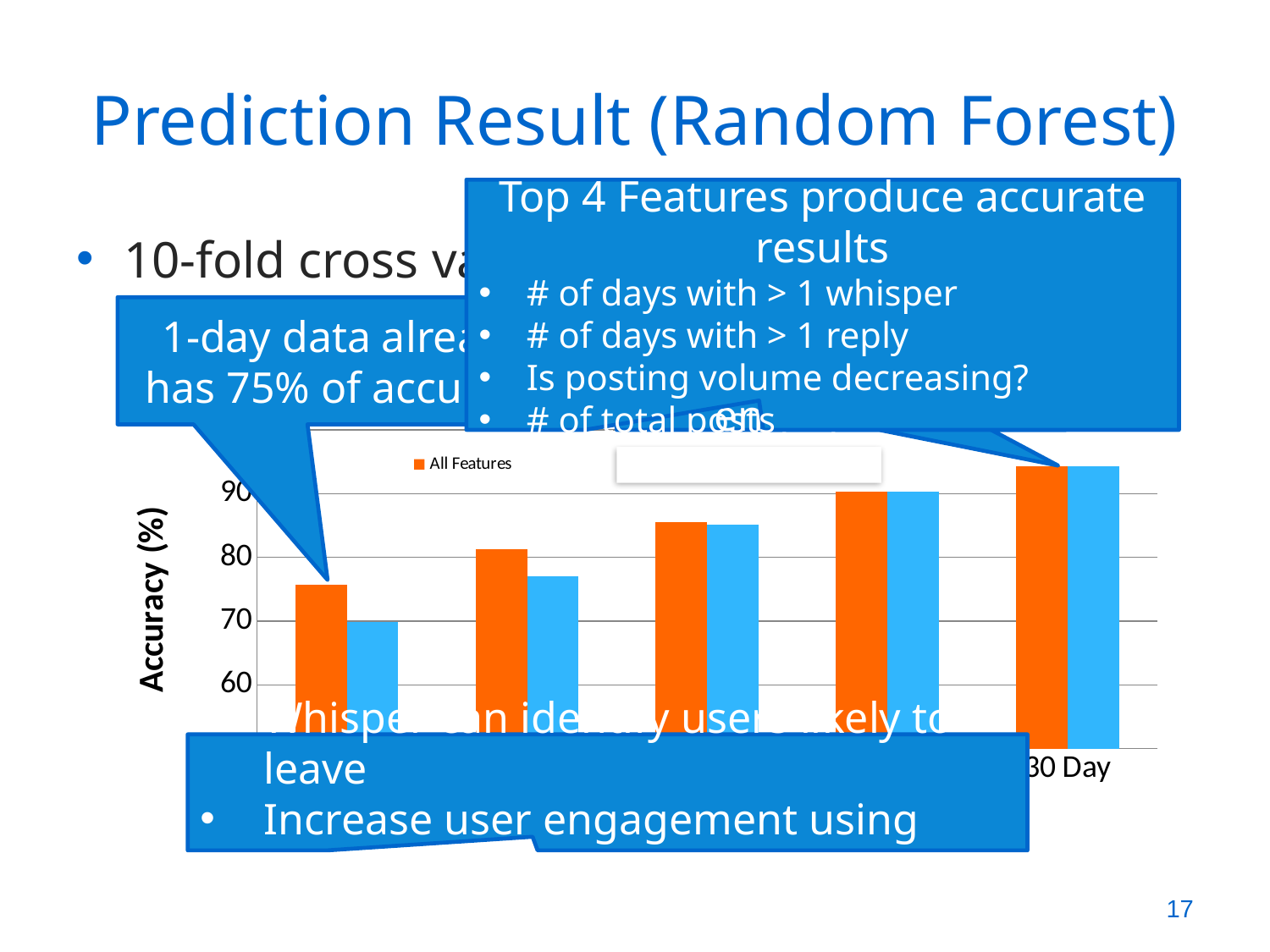
What is the label of the vertical axis of the chart? Accuracy (%) How many groups of bars (categories) are plotted along the x axis? 5 Do the blue-series accuracy values rise or fall from left to right along the x axis? rise Is the "All Features" accuracy for 30 Day greater or less than 90? greater Do the "All Features" accuracy values rise or fall from left to right along the x axis? rise Which category has the highest "All Features" accuracy? 30 Day Is the blue-series accuracy for 30 Day greater or less than 90? greater What type of chart is shown on the slide? bar chart How many bar series (colours) are plotted in the chart? 2 What colour are the bars for the "All Features" series? orange